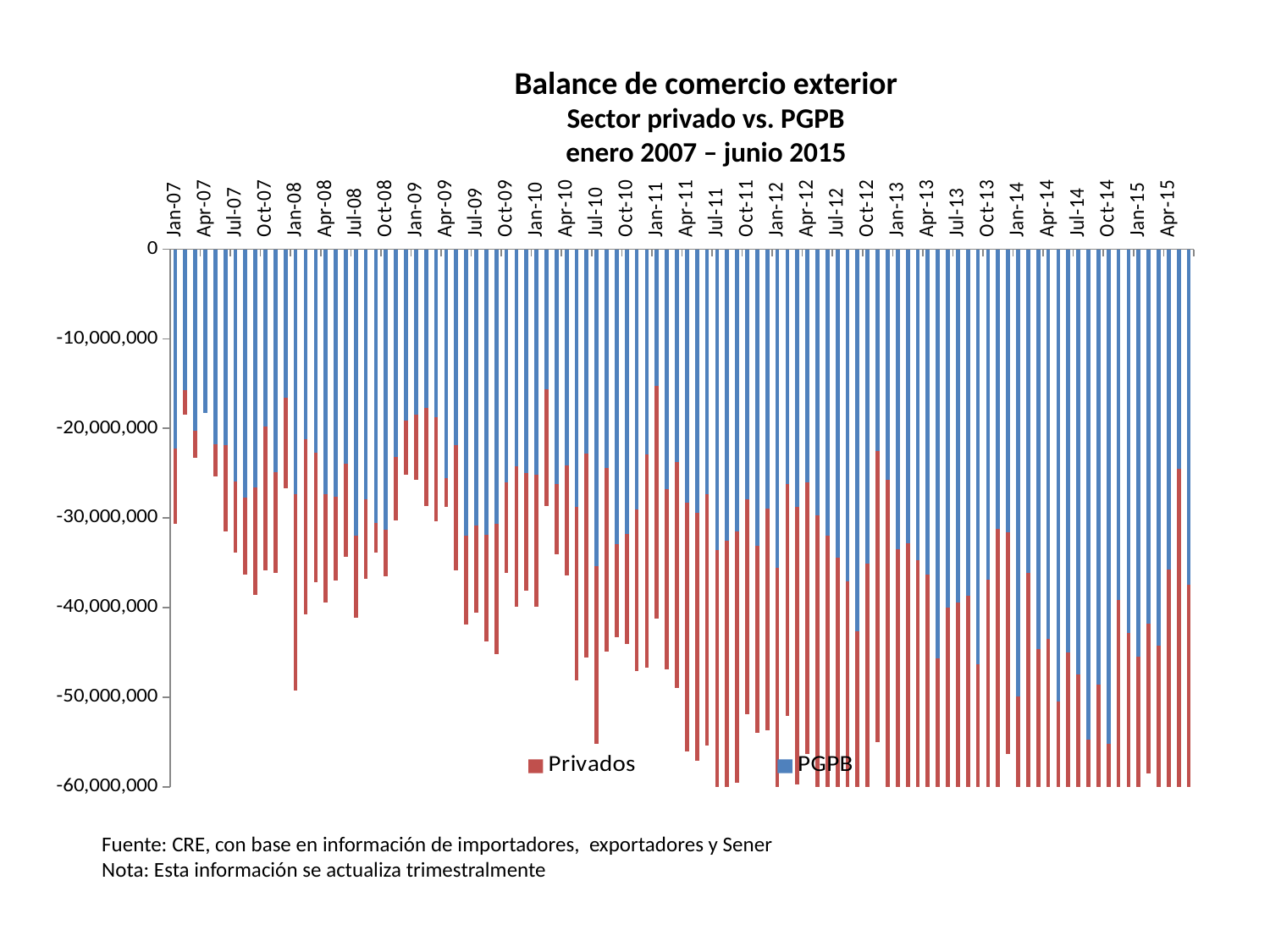
How many series does the legend list? 2 Which series is drawn in blue? PGPB Is the PGPB value for Oct-12 greater or less than -10,000,000? less What are the two series named in the legend? Privados and PGPB Is the PGPB value for Jan-11 greater or less than -20,000,000? greater Are the plotted values positive or negative? negative Overall, do the plotted values rise or fall from Jan-07 to Apr-15? fall What kind of chart is shown on the slide? bar chart What is the lowest value shown on the vertical axis? -60,000,000 Is the PGPB value for Jan-07 greater or less than -10,000,000? less